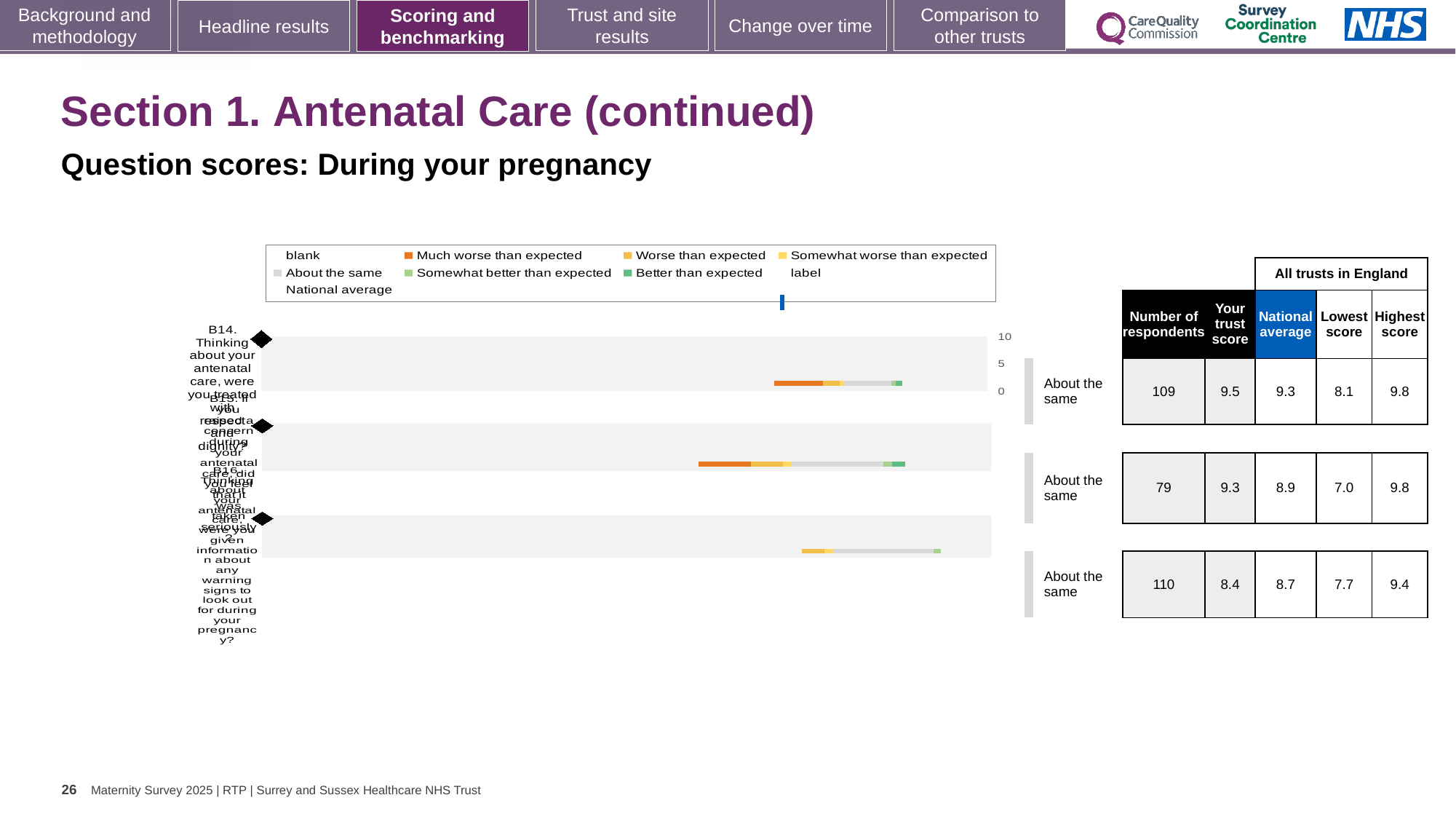
In the table beside the chart, for question B16, which is larger: the trust score or the national average? National average In the table beside the chart, what is the trust score for question B15? 9.3 In the table beside the chart, what is the highest score for question B16? 9.4 How many question rows (categories) does the bar chart show? 3 In the table beside the chart, what is the number of respondents for question B14? 109 In the table beside the chart, what is the difference between the trust score and the national average for question B14? 0.2 What kind of chart is shown on the slide? bar chart In the table beside the chart, what is the national average for question B16? 8.7 In the table beside the chart, which question has the lowest 'Lowest score'? B15 Which legend entry is shown in orange on the bar chart? Much worse than expected In the table beside the chart, which question has the highest number of respondents? B16 What is the benchmark category shown next to each bar in the chart? About the same